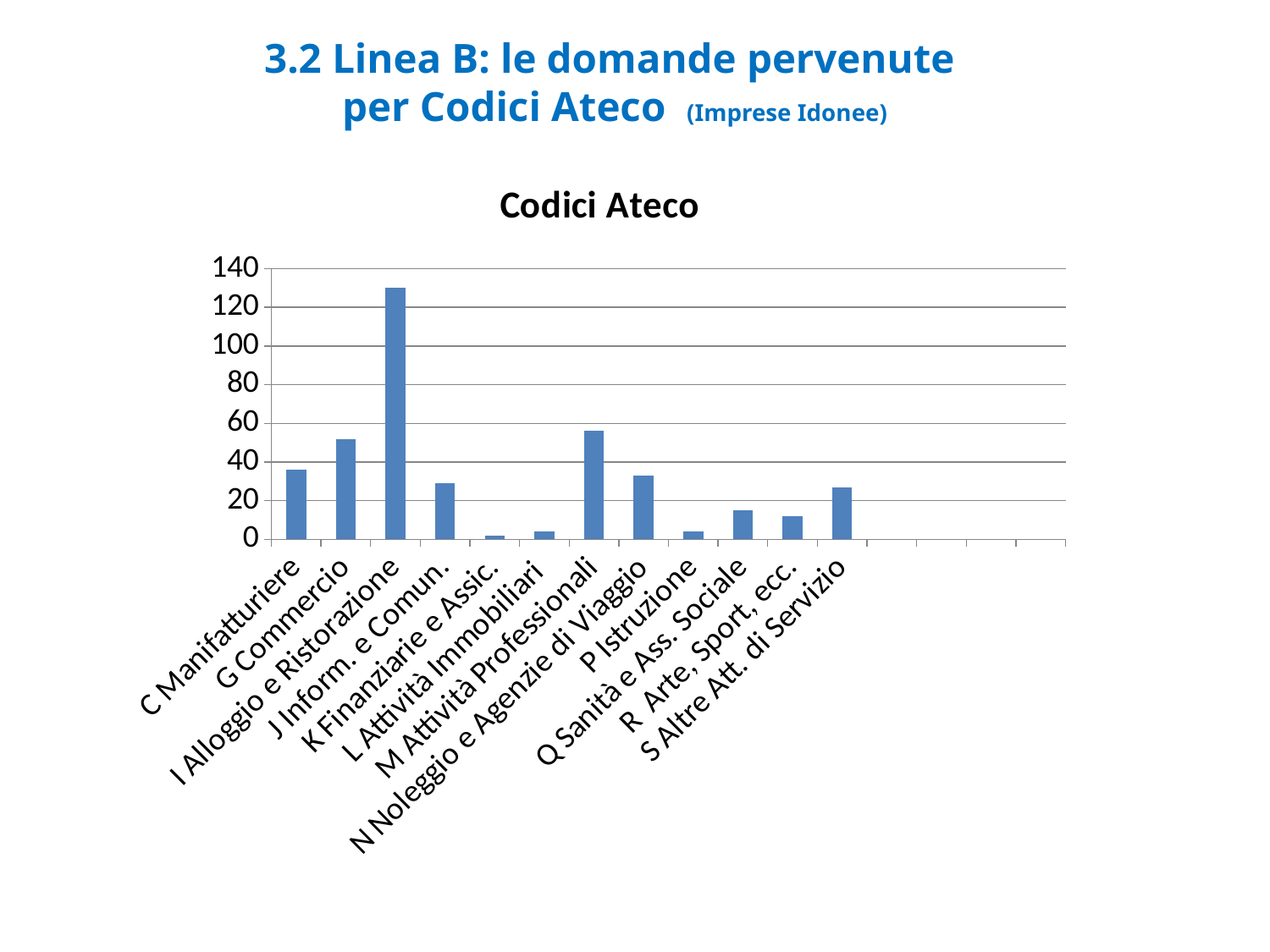
Is the value for C Manifatturiere greater or less than 20? greater What kind of chart is shown on the slide? bar chart Which category has the highest value? I Alloggio e Ristorazione Is the value for J Inform. e Comun. greater or less than 40? less Is the value for I Alloggio e Ristorazione greater or less than 120? greater How many categories are plotted on the x axis? 12 What is the title of the chart? Codici Ateco Which is larger, the value for I Alloggio e Ristorazione or the value for M Attività Professionali? I Alloggio e Ristorazione Which is larger, the value for G Commercio or the value for N Noleggio e Agenzie di Viaggio? G Commercio